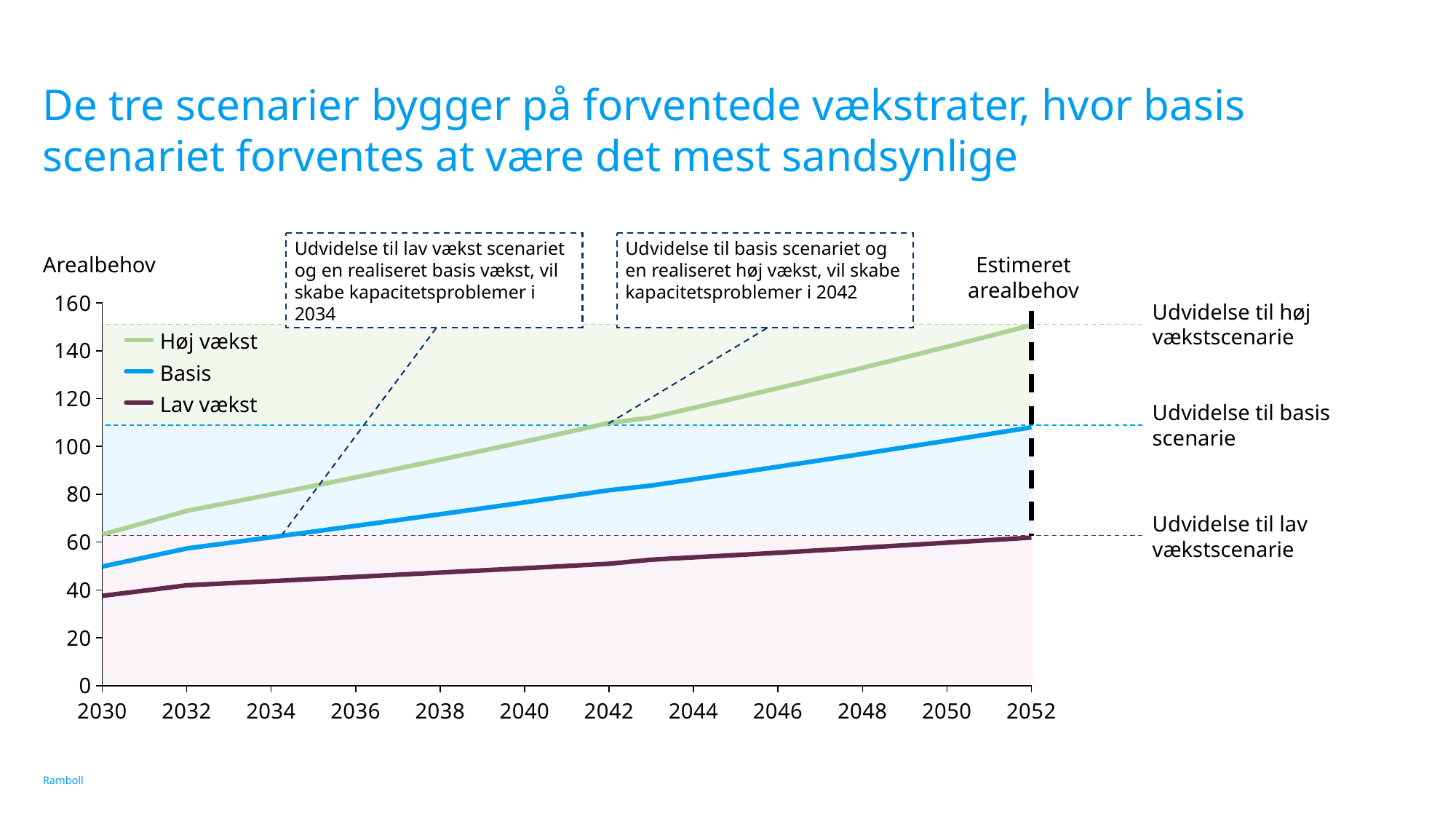
Which series has the lowest value in 2030? Lav vækst Is the value for Basis in 2052 greater or less than 100? greater Does the Basis series rise or fall from 2030 to 2052? rise In 2040, which is larger: the Basis value or the Lav vækst value? Basis What kind of chart is shown on the slide? line chart Which series has the highest value in 2052? Høj vækst Is the value for Lav vækst in 2052 greater or less than 80? less What is the label on the y axis of the chart? Arealbehov Is the value for Høj vækst in 2052 greater or less than 140? greater What is the last year shown on the x axis? 2052 How many series does the legend list? 3